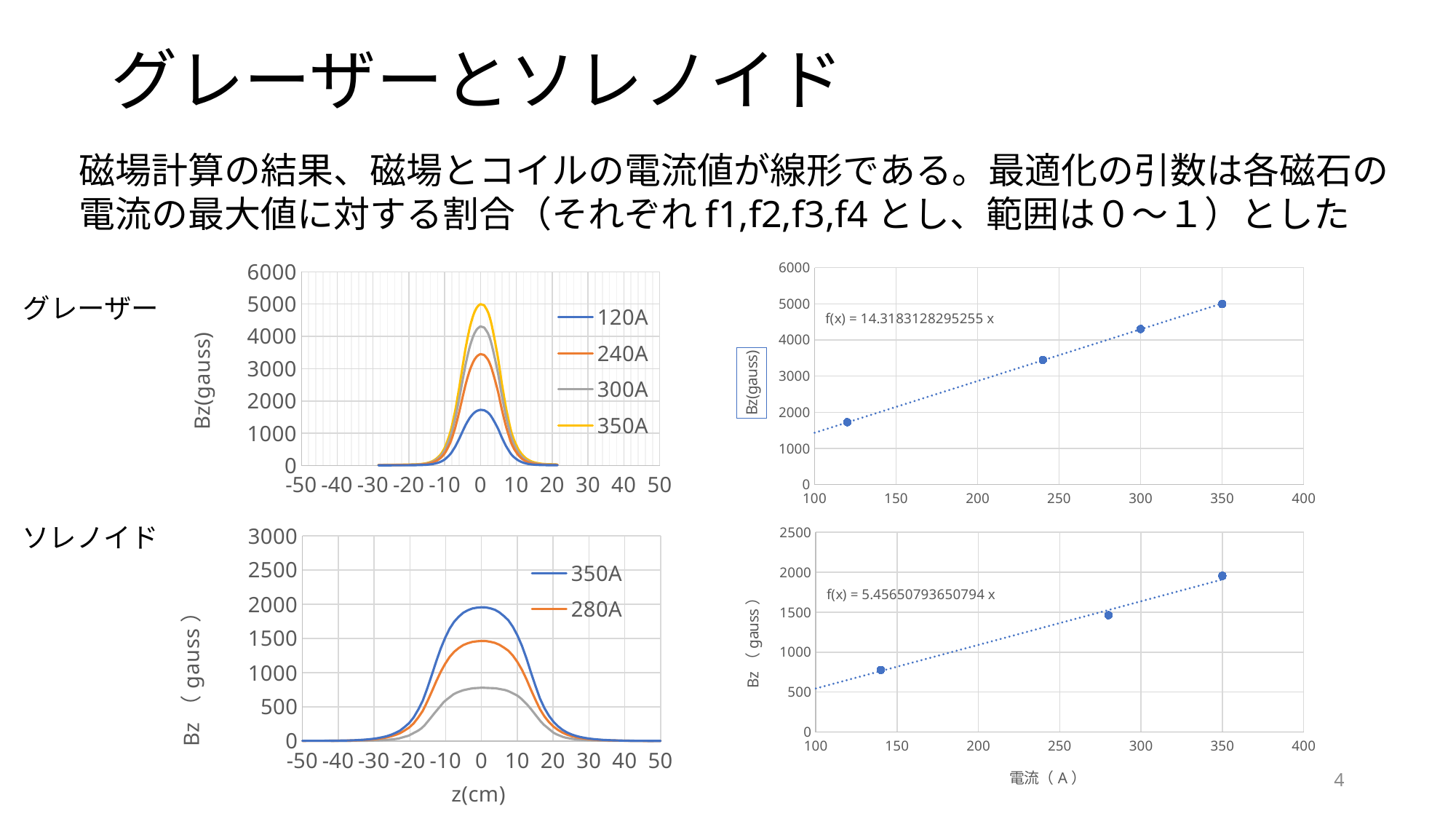
In the bottom-right chart, does Bz rise or fall as the current (電流) increases? rise In the top-left chart (グレーザー), which series reaches the highest peak value of Bz? 350A In the bottom-left chart (ソレノイド), is the peak value of the 280A series greater or less than 1000? greater In the bottom-right chart, what is the trendline equation shown? f(x) = 5.45650793650794 x In the bottom-left chart (ソレノイド), which series has the higher peak, 350A or 280A? 350A In the top-left chart (グレーザー), which series has the lowest peak value of Bz? 120A In the bottom-left chart (ソレノイド), how many series does the legend list? 2 In the top-right chart, how many data points are plotted? 4 In the top-left chart (グレーザー), how many series does the legend list? 4 In the top-right chart, what is the trendline equation shown? f(x) = 14.3183128295255 x In the top-left chart (グレーザー), is the peak value of the 350A series greater or less than 4000? greater In the top-left chart (グレーザー), is the peak value of the 120A series greater or less than 2000? less